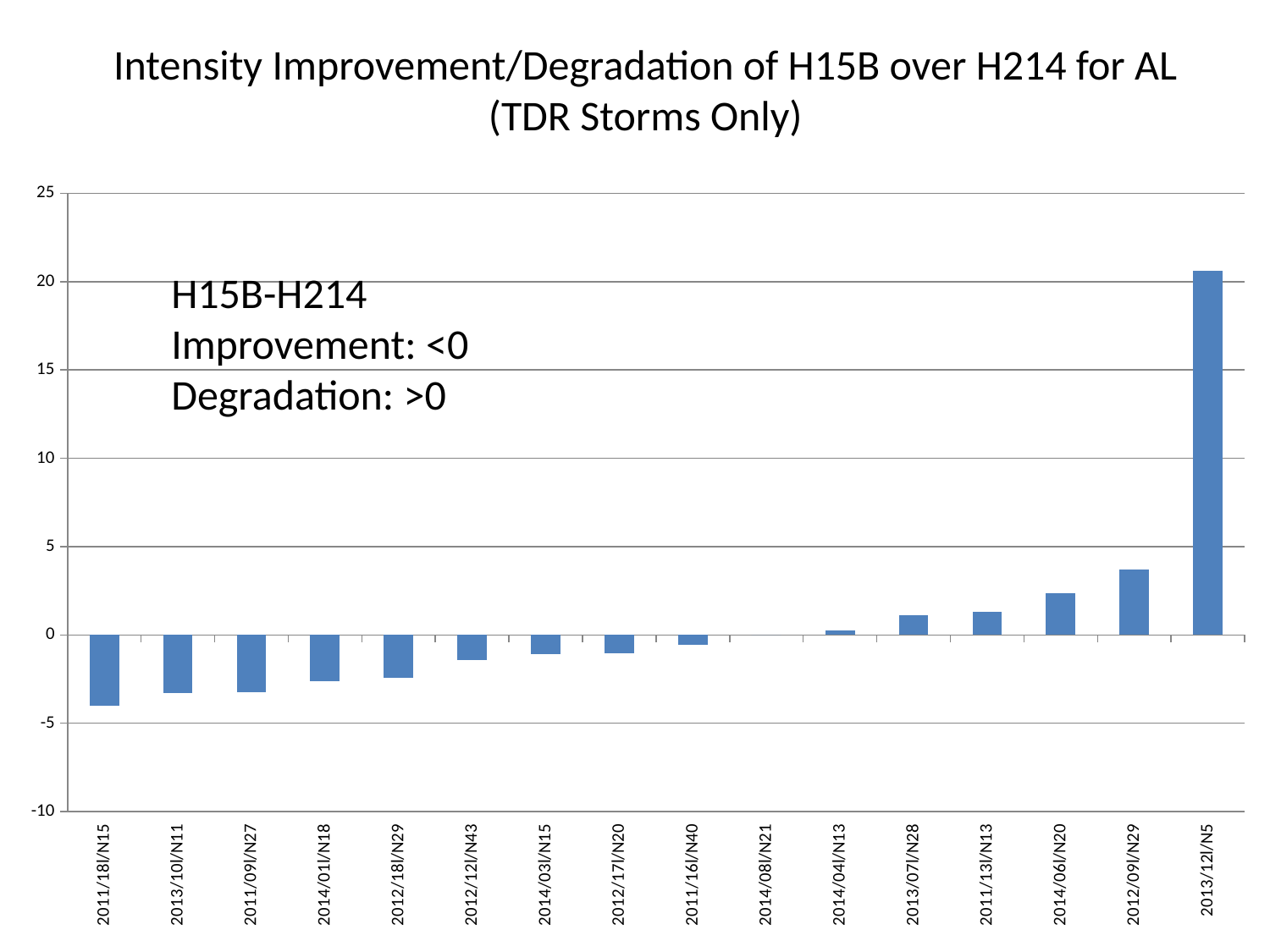
Is the value for 2013/12l/N5 greater or less than 15? greater Is the value for 2011/18l/N15 greater or less than -5? greater Do the values generally rise or fall moving from left to right along the x axis? rise According to the text on the chart, does a value below 0 indicate improvement or degradation? Improvement Which category has the highest value? 2013/12l/N5 How many categories (storm cases) are plotted along the x axis? 16 Which has the larger value, 2013/12l/N5 or 2012/09l/N29? 2013/12l/N5 Which has the larger value, 2011/18l/N15 or 2014/06l/N20? 2014/06l/N20 Is the value for 2012/09l/N29 greater or less than 5? less What kind of chart is shown on the slide? bar chart Which category has the lowest value? 2011/18l/N15